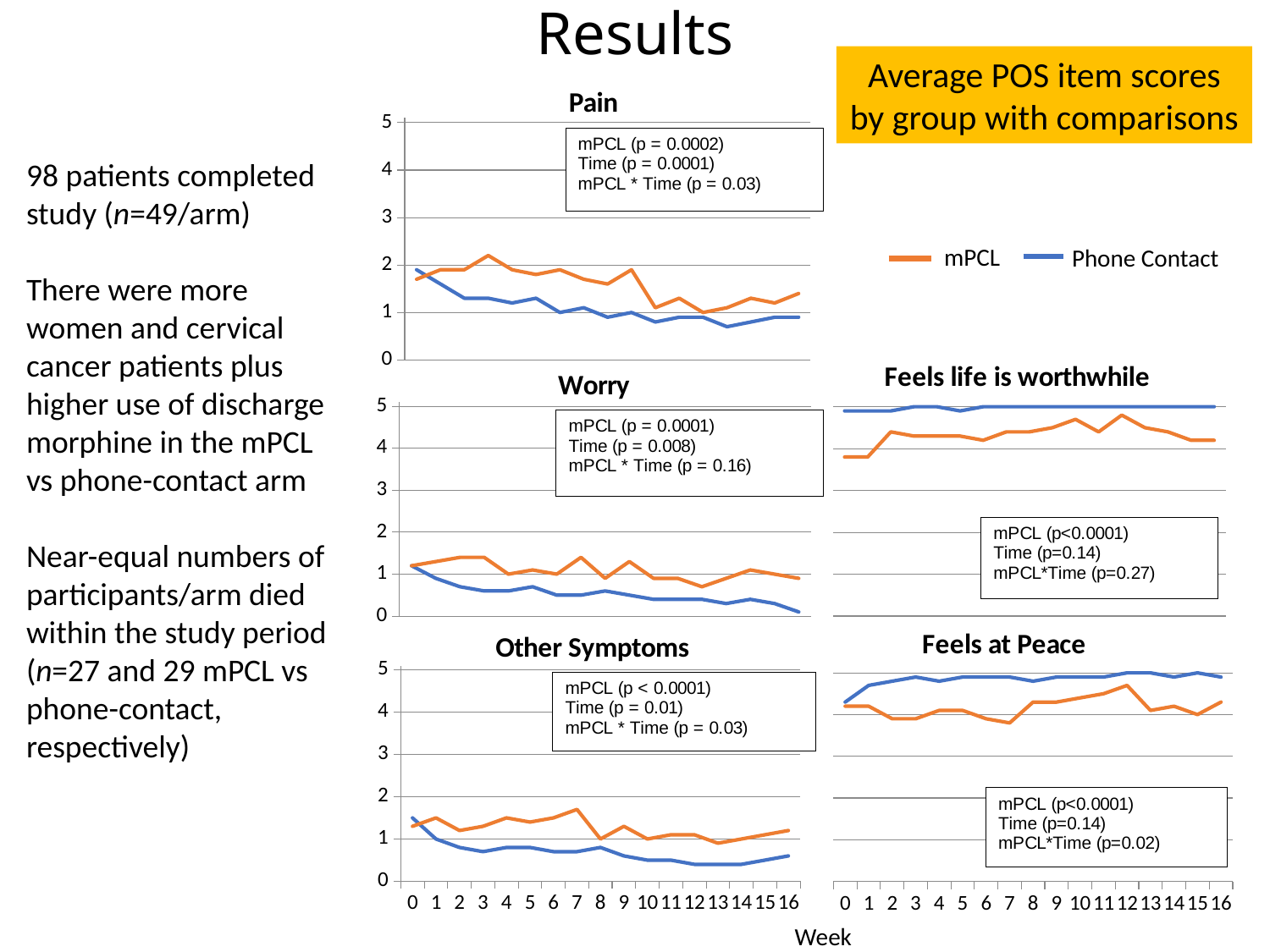
How many series does the legend list for the charts? 2 In the Feels life is worthwhile chart, is the value for Phone Contact at week 0 greater or less than 4? greater How many charts are shown on the slide? 5 In the Worry chart, which series has the higher value at week 16, mPCL or Phone Contact? mPCL In the Feels at Peace chart, is the value for Phone Contact at week 12 greater or less than 4? greater What kind of chart is the Pain chart? line chart In the Feels life is worthwhile chart, which series has the higher value at week 0, mPCL or Phone Contact? Phone Contact In the Other Symptoms chart, how many weeks are plotted along the x axis? 17 What colour is the mPCL series in the legend? orange In the Pain chart, is the value for mPCL at week 0 greater or less than 1? greater In the Other Symptoms chart, does the Phone Contact line rise or fall from week 0 to week 16? fall In the Worry chart, does the Phone Contact line rise or fall from week 0 to week 16? fall